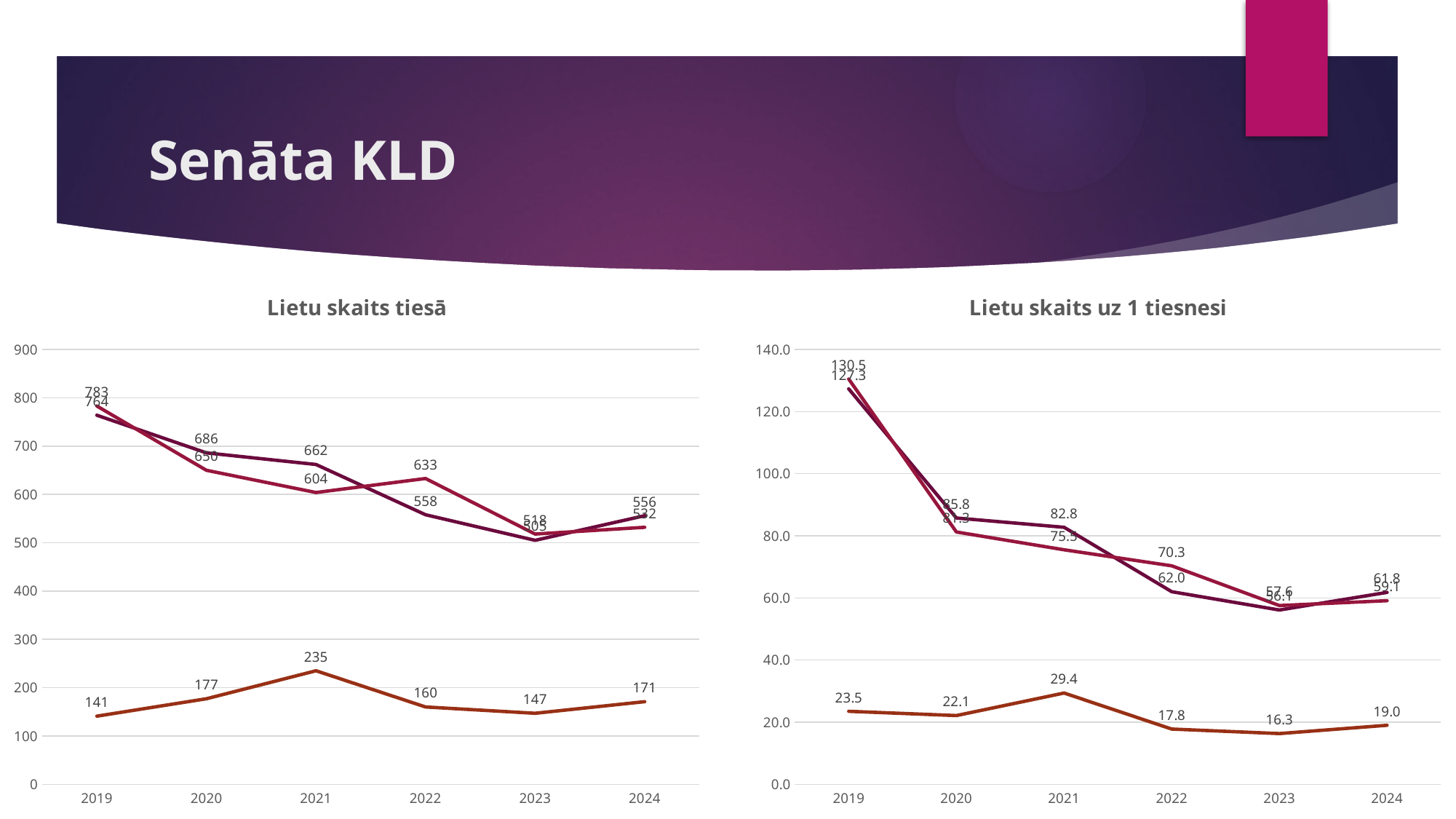
In the 'Lietu skaits uz 1 tiesnesi' chart, is the orange line's 2022 value greater or less than 20.0? less What is the title of the chart on the right side of the slide? Lietu skaits uz 1 tiesnesi In the 'Lietu skaits uz 1 tiesnesi' chart, what is the value of the orange (lowest) line in 2023? 16.3 In the 'Lietu skaits tiesā' chart, what is the difference between the orange line's 2021 value and its 2019 value? 94 In the 'Lietu skaits tiesā' chart, in which year does the orange (lowest) line reach its highest value? 2021 In the 'Lietu skaits tiesā' chart, in which year does the orange (lowest) line have its lowest value? 2019 In the 'Lietu skaits uz 1 tiesnesi' chart, do the two upper lines generally rise or fall from 2019 to 2023? fall In the 'Lietu skaits uz 1 tiesnesi' chart, what is the value of the orange (lowest) line in 2021? 29.4 How many years are shown on the x axis of the 'Lietu skaits uz 1 tiesnesi' chart? 6 In the 'Lietu skaits tiesā' chart, what is the value of the orange (lowest) line in 2021? 235 In the 'Lietu skaits uz 1 tiesnesi' chart, is the orange line's value in 2021 larger or smaller than its value in 2020? larger What kind of chart is the 'Lietu skaits tiesā' chart? line chart